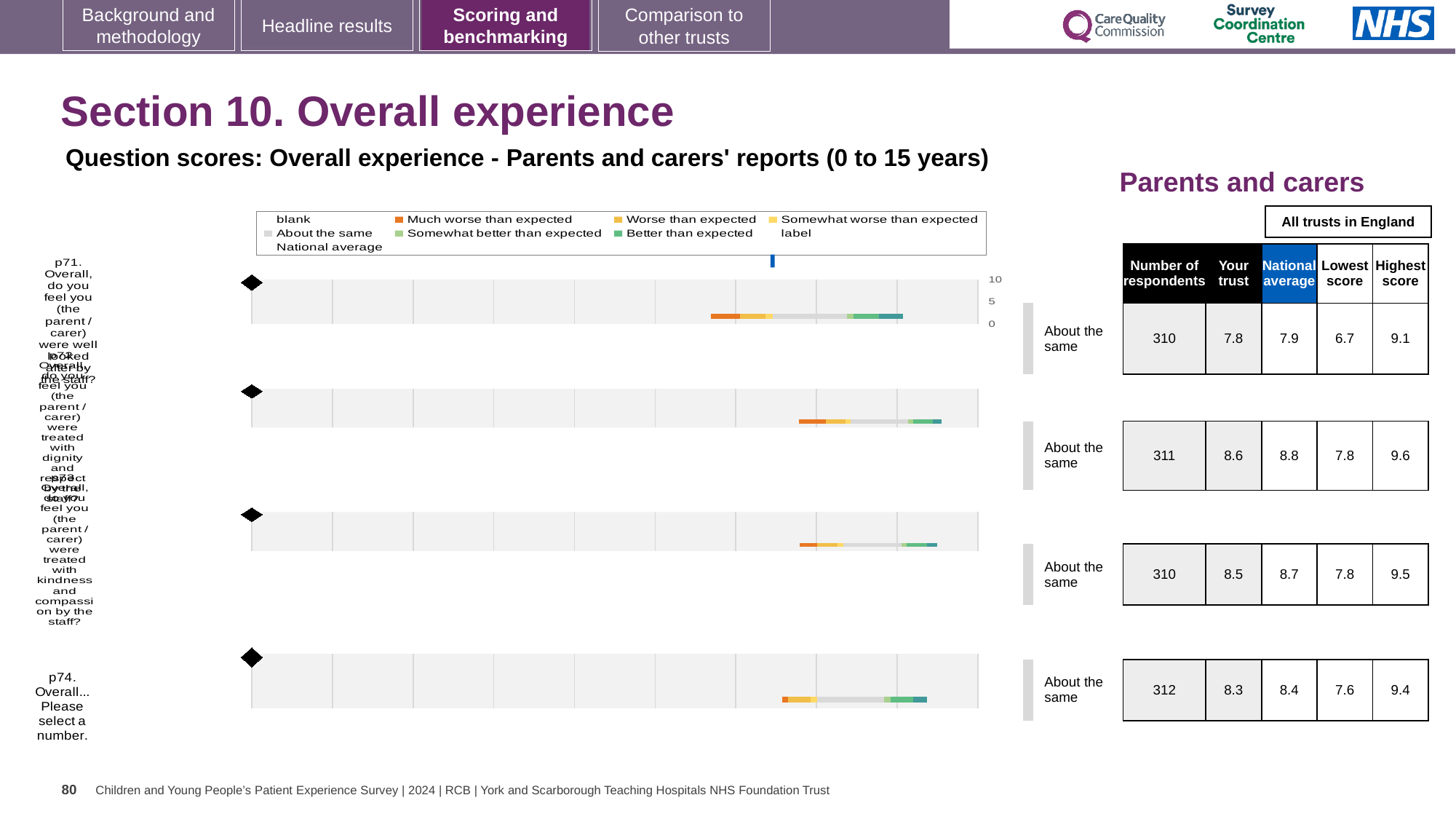
What benchmark category is shown for all four questions? About the same How many questions (bars) are plotted in the chart? 4 What kind of chart is used to show the question scores on this slide? bar chart Which question has the lowest 'Your trust' score? p71 For p73, which is larger: the 'Your trust' score or the national average? National average What is the highest score across all trusts in England for p71? 9.1 What is the number of respondents for p74 (Overall... Please select a number)? 312 What is the 'Your trust' score for p71 (Overall, do you feel you were well looked after by the staff?)? 7.8 What colour represents 'Much worse than expected' in the legend? Orange What is the national average score for p72 (treated with dignity and respect)? 8.8 For p72, what is the difference between the national average and the 'Your trust' score? 0.2 Which question has the highest 'Your trust' score? p72